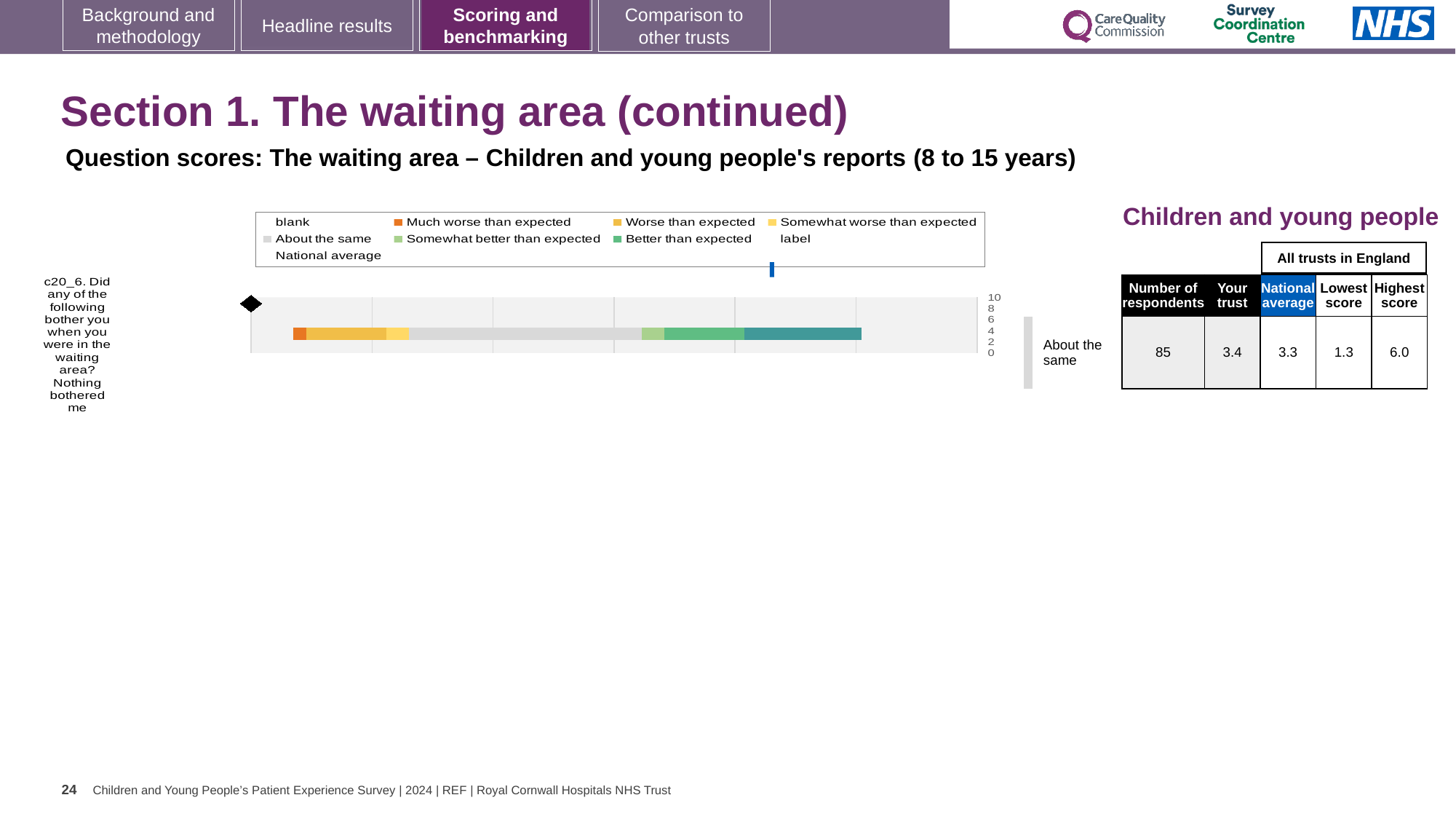
Which is larger for question c20_6, the 'Your trust' score or the national average? Your trust What is the lowest score among all trusts in England for question c20_6? 1.3 What is the national average score for question c20_6? 3.3 What kind of chart is used to show the question score for c20_6? bar chart How many question bars are plotted in the chart? 1 What is the difference between the highest score and the lowest score for question c20_6? 4.7 Which question code is plotted in the chart? c20_6 How many respondents answered question c20_6? 85 By how much does the 'Your trust' score exceed the national average for question c20_6? 0.1 What benchmark category label is shown to the right of the bar for question c20_6? About the same What is the highest score among all trusts in England for question c20_6? 6.0 What is the 'Your trust' score for question c20_6? 3.4